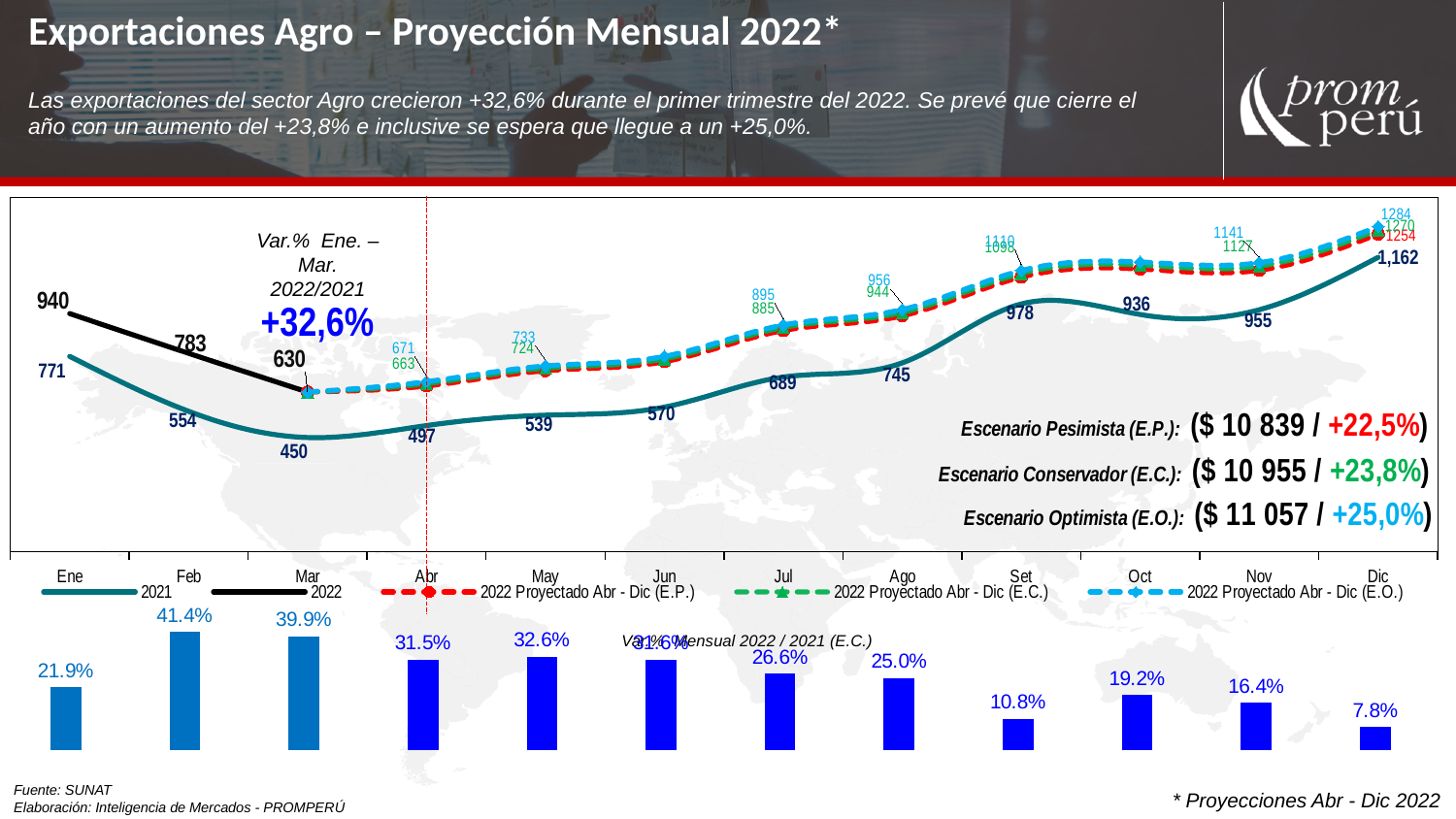
In the bottom bar chart (Var.% Mensual 2022 / 2021 (E.C.)), which month has the lowest value? Dic In the top line chart, which month had the lowest value for the 2021 series? Mar What is the projected total and growth shown for the Escenario Optimista (E.O.)? $ 11 057 / +25,0% In the top line chart, which is larger: the 2021 value in Set or the 2021 value in Oct? Set In the top line chart, what is the difference between the 2022 value and the 2021 value in Feb? 229 In the top line chart, what was the value for 2022 in Ene? 940 How many series does the legend of the top line chart list? 5 In the bottom bar chart (Var.% Mensual 2022 / 2021 (E.C.)), which month has the highest value? Feb What kind of chart is the bottom chart showing Var.% Mensual 2022 / 2021 (E.C.)? Bar chart In the bottom bar chart (Var.% Mensual 2022 / 2021 (E.C.)), what is the value for Feb? 41.4% In the top line chart, what was the value for 2021 in Dic? 1,162 In the top line chart, what was the value for 2021 in Mar? 450